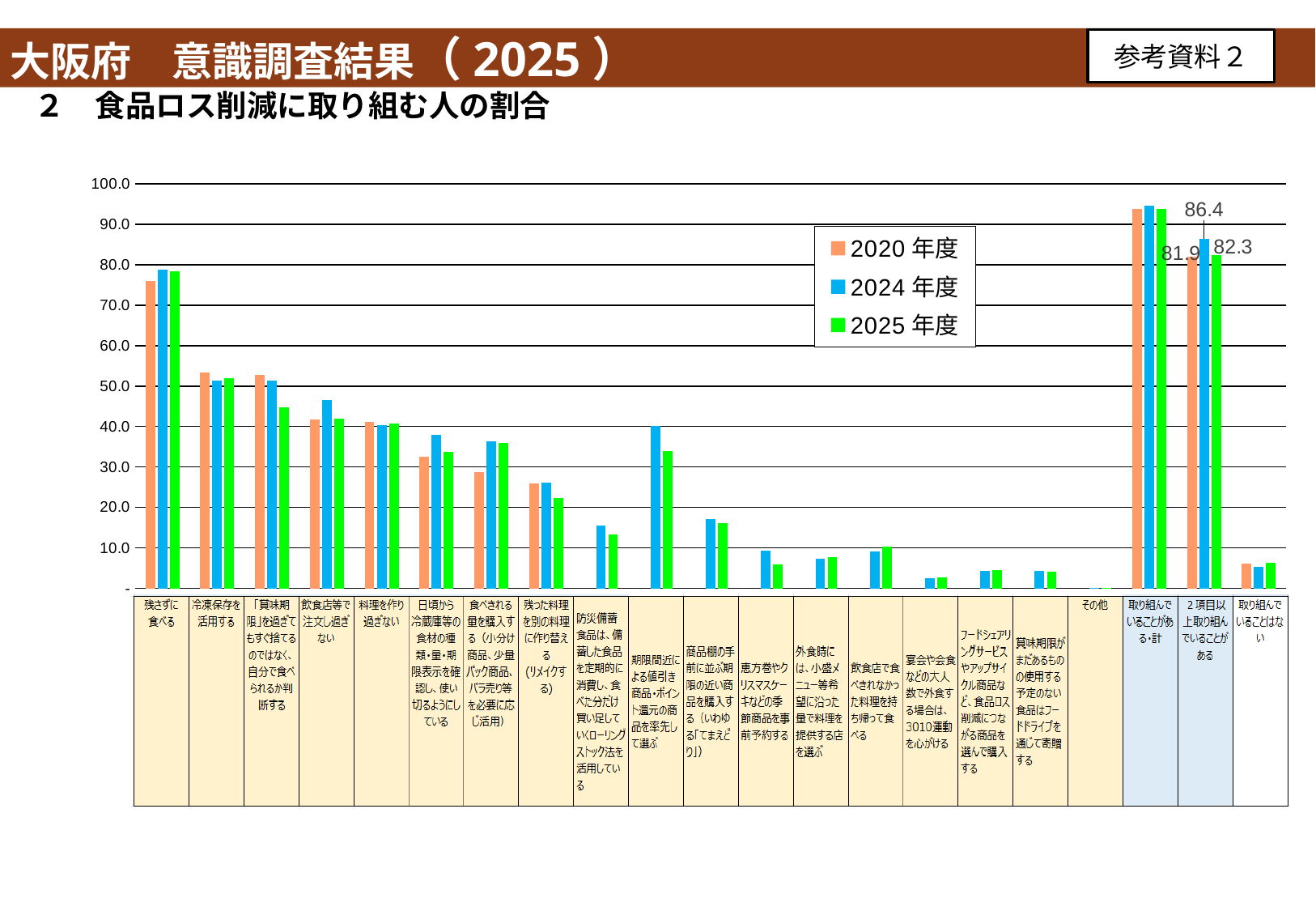
Which series are listed in the legend? 2020年度, 2024年度, 2025年度 For 「２項目以上取り組んでいることがある」, what is the difference between the 2024年度 and 2020年度 values? 4.5 What is the 2024年度 value for 「２項目以上取り組んでいることがある」? 86.4 For 「２項目以上取り組んでいることがある」, what is the difference between the 2024年度 and 2025年度 values? 4.1 What is the 2025年度 value for 「２項目以上取り組んでいることがある」? 82.3 Which category has the highest 2025年度 value? 取り組んでいることがある・計 What kind of chart is shown on the slide? Bar chart What is the 2020年度 value for 「２項目以上取り組んでいることがある」? 81.9 How many series does the legend list? 3 Is the 2025年度 value for 「残さずに食べる」 greater or less than 70? greater For 「２項目以上取り組んでいることがある」, which is larger: the 2020年度 value or the 2025年度 value? 2025年度 Is the 2024年度 value for 「期限間近による値引き商品・ポイント還元の商品を率先して選ぶ」 greater or less than 30? greater